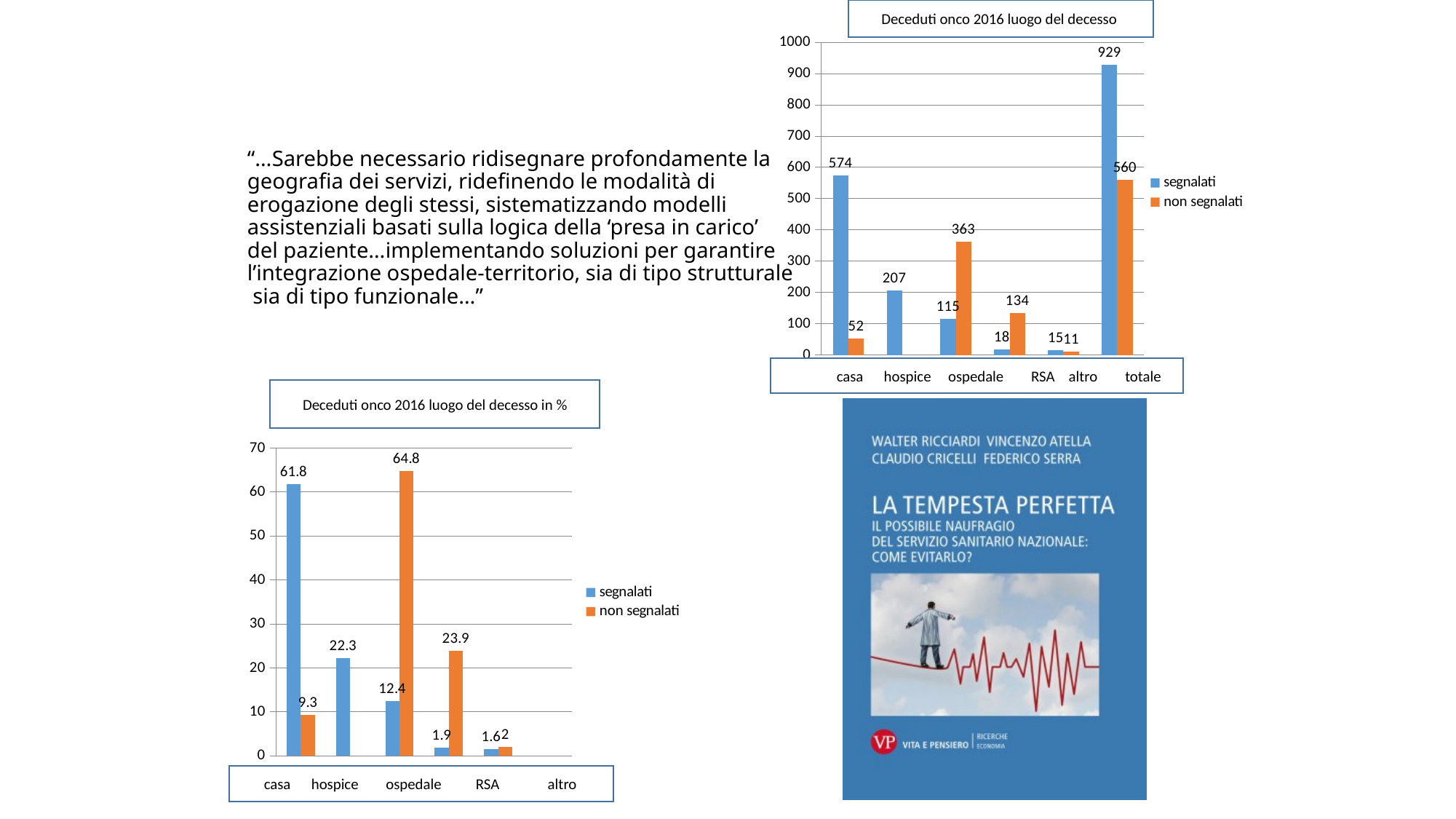
In the chart titled 'Deceduti onco 2016 luogo del decesso', what is the value for segnalati in casa? 574 In the chart titled 'Deceduti onco 2016 luogo del decesso', what is the totale value for non segnalati? 560 In the chart titled 'Deceduti onco 2016 luogo del decesso', how many series does the legend list? 2 In the chart titled 'Deceduti onco 2016 luogo del decesso in %', which category has the highest segnalati value? casa In the chart titled 'Deceduti onco 2016 luogo del decesso in %', what is the value for non segnalati in ospedale? 64.8 In the chart titled 'Deceduti onco 2016 luogo del decesso', what is the value for non segnalati in ospedale? 363 In the chart titled 'Deceduti onco 2016 luogo del decesso in %', what is the value for segnalati in casa? 61.8 In the chart titled 'Deceduti onco 2016 luogo del decesso in %', what is the difference between non segnalati and segnalati for ospedale? 52.4 What kind of chart is 'Deceduti onco 2016 luogo del decesso in %'? bar chart In the chart titled 'Deceduti onco 2016 luogo del decesso', which series has the larger value for ospedale, segnalati or non segnalati? non segnalati In the chart titled 'Deceduti onco 2016 luogo del decesso', how many categories are shown on the x axis? 6 In the chart titled 'Deceduti onco 2016 luogo del decesso', what is the difference between segnalati and non segnalati for casa? 522